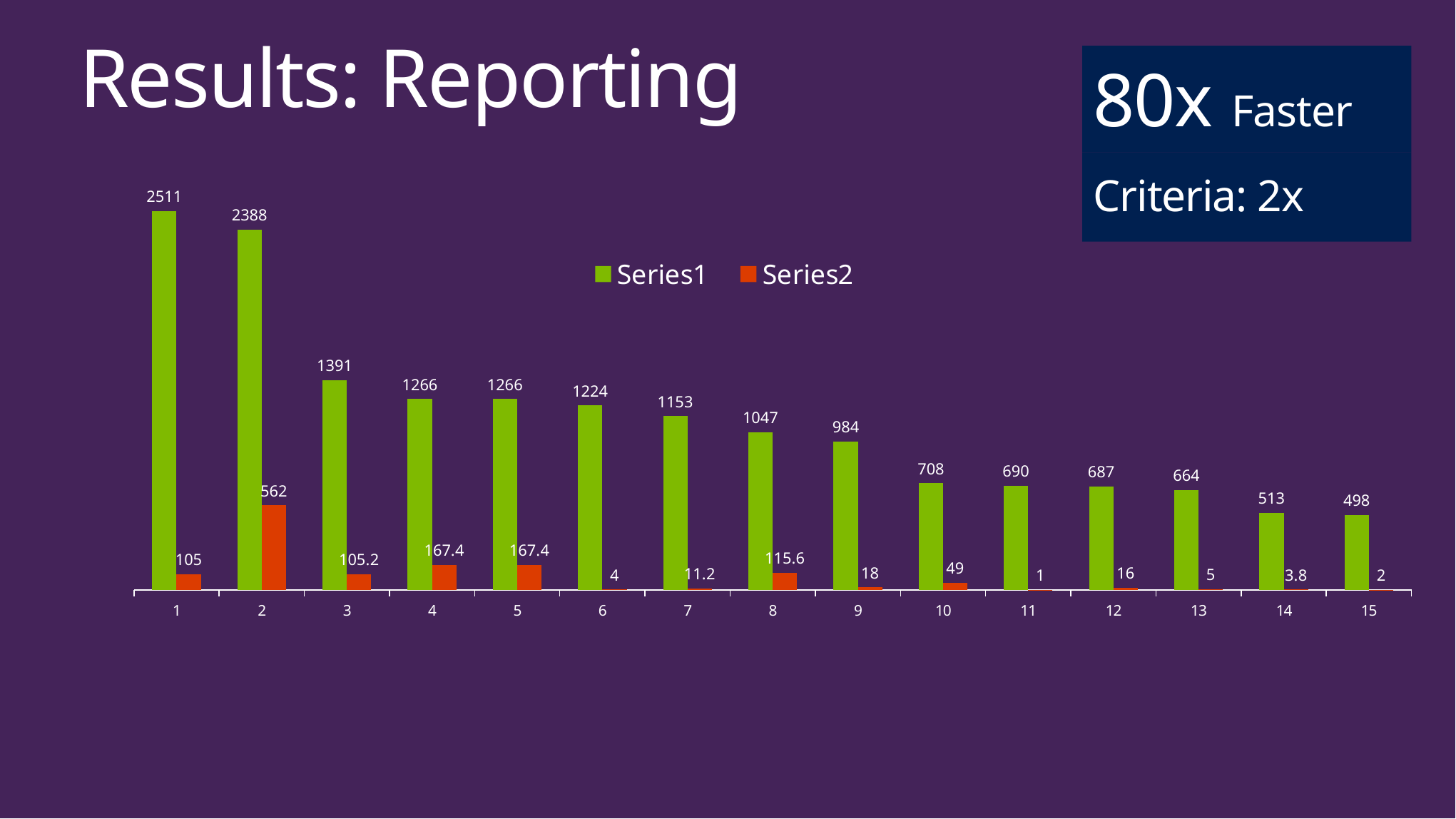
What is the Series1 value for category 15? 498 Which is larger, the Series2 value for category 10 or for category 12? Category 10 What kind of chart is shown on the slide? Bar chart How many categories are shown on the x axis? 15 What is the Series2 value for category 2? 562 What is the difference between the Series1 values for categories 1 and 2? 123 Do the Series1 values generally rise or fall from category 1 to category 15? Fall Which category has the lowest Series2 value? 11 Which category has the highest Series1 value? 1 What is the Series1 value for category 1? 2511 What is the Series2 value for category 7? 11.2 How many series does the legend list? 2